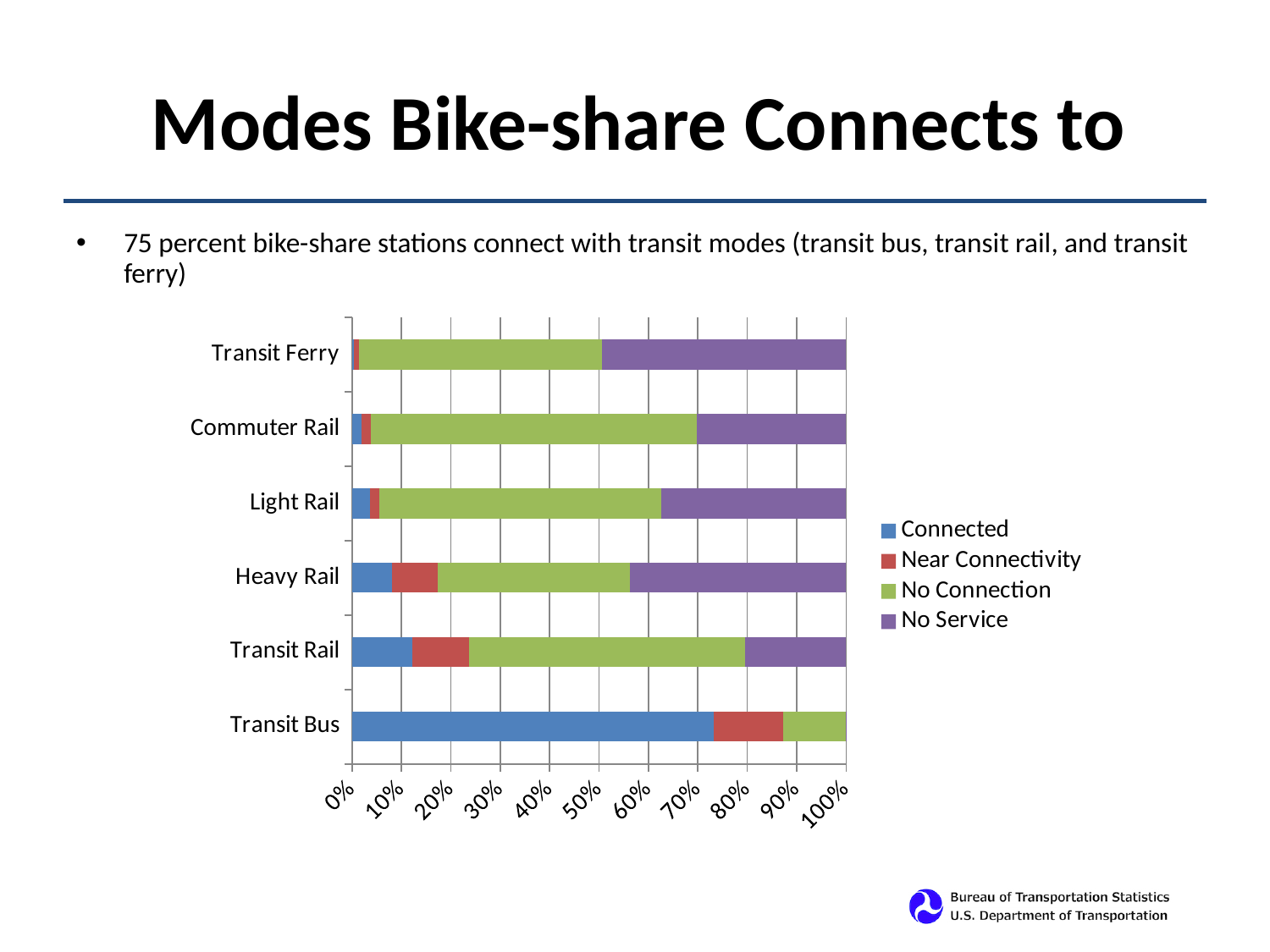
Which has a larger No Service share, Transit Ferry or Commuter Rail? Transit Ferry Which legend entry is shown in purple? No Service Is the Connected share for Heavy Rail greater or less than 10%? less What kind of chart is shown on the slide? Stacked bar chart Which has a larger Connected share, Transit Rail or Heavy Rail? Transit Rail How many transit modes (categories) are shown on the chart? 6 Is the Connected share for Transit Bus greater or less than 70%? greater What is the title of the slide containing the chart? Modes Bike-share Connects to Which transit mode has the smallest No Service share? Transit Bus How many series does the chart legend list? 4 Is the No Service share for Commuter Rail greater or less than 20%? greater Which transit mode has the largest Connected share? Transit Bus